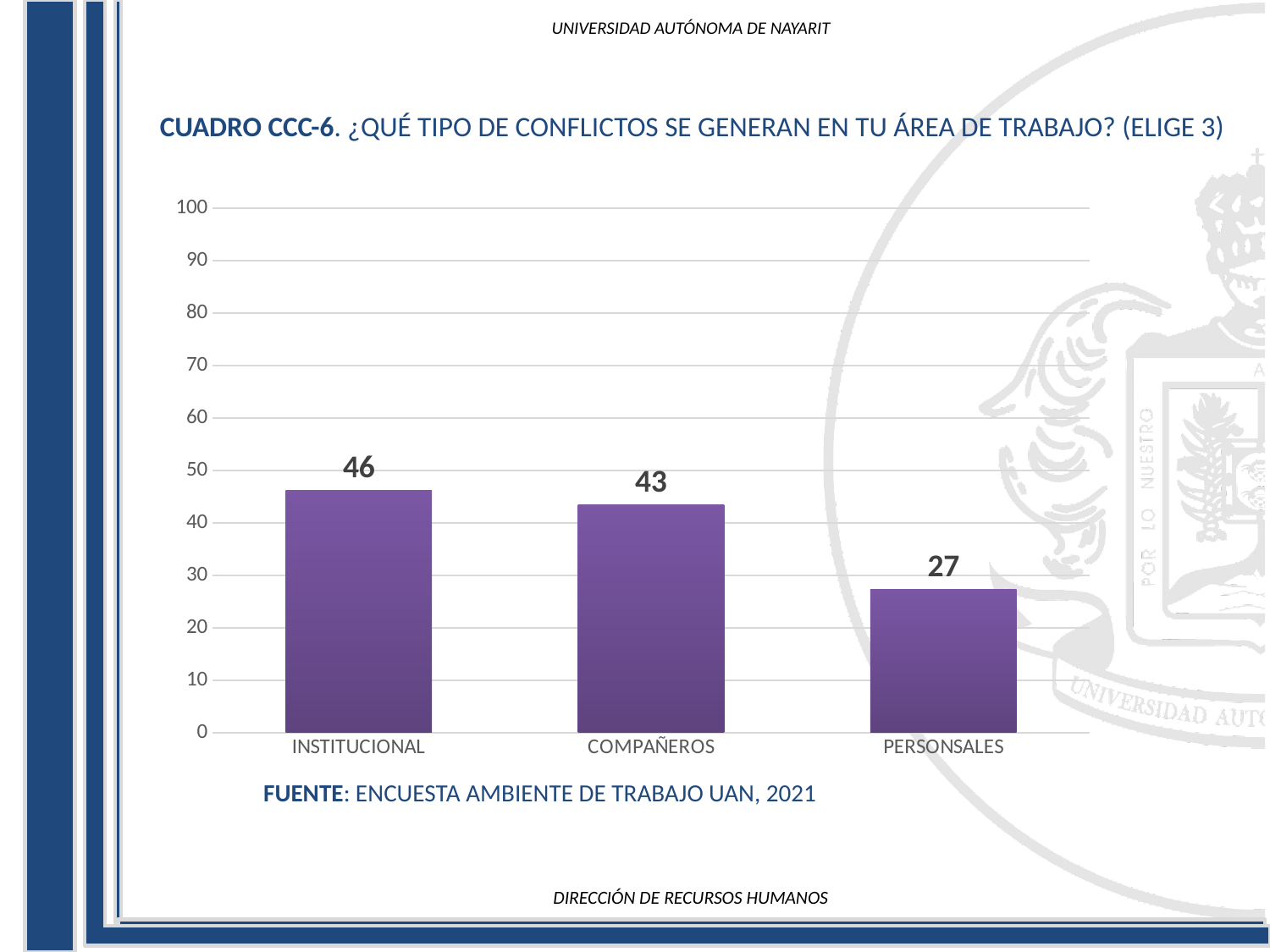
Which category has the highest value? INSTITUCIONAL What is the difference between the values for INSTITUCIONAL and PERSONSALES? 19 Is the value for PERSONSALES greater or less than 30? less What kind of chart is shown on the slide? bar chart What is the value for COMPAÑEROS? 43 Do the values rise or fall from left to right along the x axis? fall Which category has the lowest value? PERSONSALES What is the difference between the values for COMPAÑEROS and PERSONSALES? 16 Which is larger, the value for COMPAÑEROS or the value for PERSONSALES? COMPAÑEROS What is the value for INSTITUCIONAL? 46 How many categories are shown on the x axis? 3 What is the value for PERSONSALES? 27